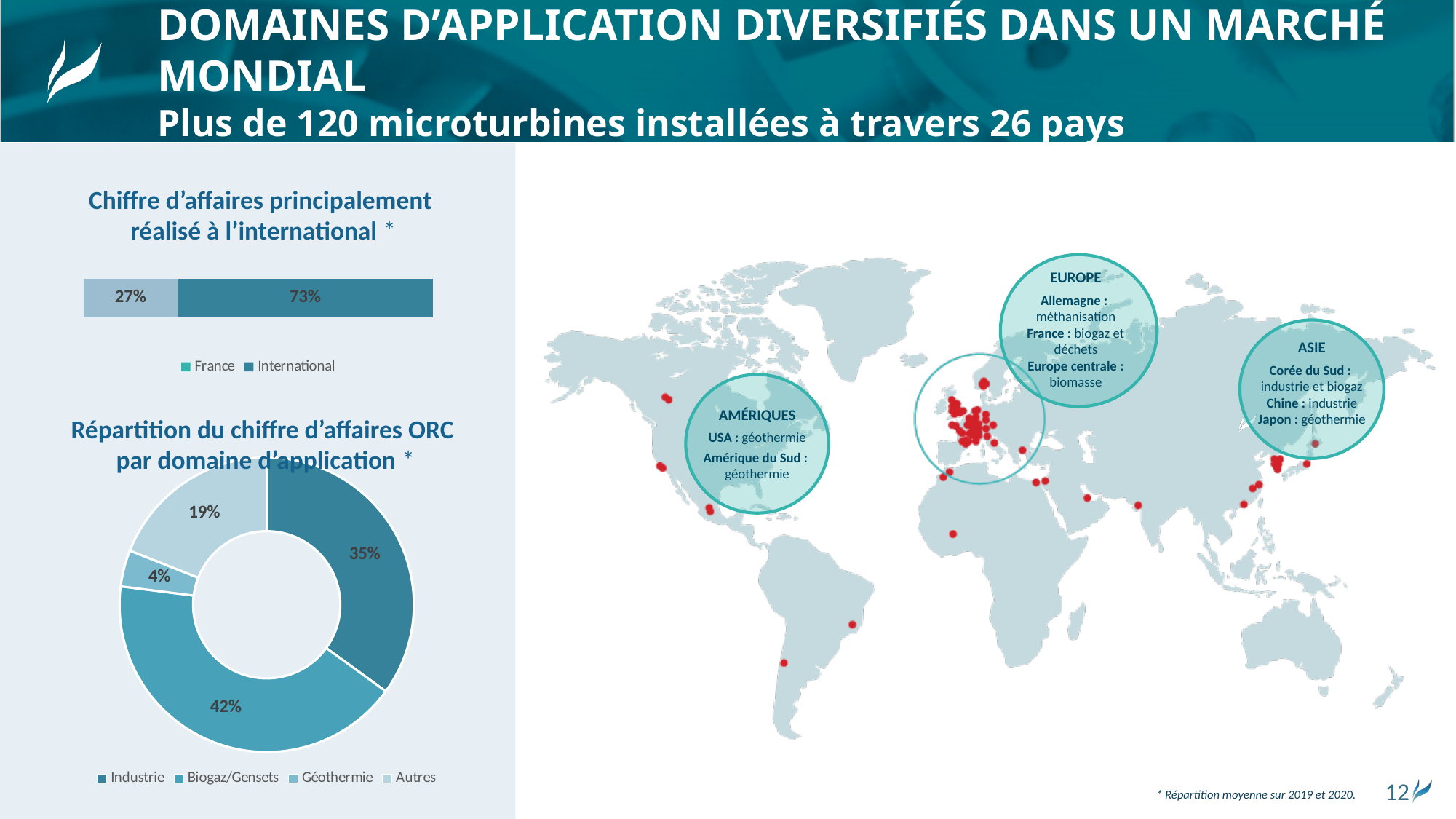
What kind of chart is 'Répartition du chiffre d'affaires ORC par domaine d'application'? Donut chart In the chart 'Répartition du chiffre d'affaires ORC par domaine d'application', what is the share for Géothermie? 4% What kind of chart is 'Chiffre d'affaires principalement réalisé à l'international'? Bar chart In the chart 'Répartition du chiffre d'affaires ORC par domaine d'application', which domain has the largest share? Biogaz/Gensets In the chart 'Répartition du chiffre d'affaires ORC par domaine d'application', what is the share for Biogaz/Gensets? 42% In the chart 'Répartition du chiffre d'affaires ORC par domaine d'application', what is the share for Industrie? 35% In the chart 'Répartition du chiffre d'affaires ORC par domaine d'application', how many categories are shown? 4 In the chart 'Chiffre d'affaires principalement réalisé à l'international', what is the difference between the International and France values? 46% In the chart 'Répartition du chiffre d'affaires ORC par domaine d'application', which domain has the smallest share? Géothermie In the chart 'Chiffre d'affaires principalement réalisé à l'international', how many series does the legend list? 2 In the chart 'Chiffre d'affaires principalement réalisé à l'international', what is the value for France? 27% In the chart 'Chiffre d'affaires principalement réalisé à l'international', what is the value for International? 73%